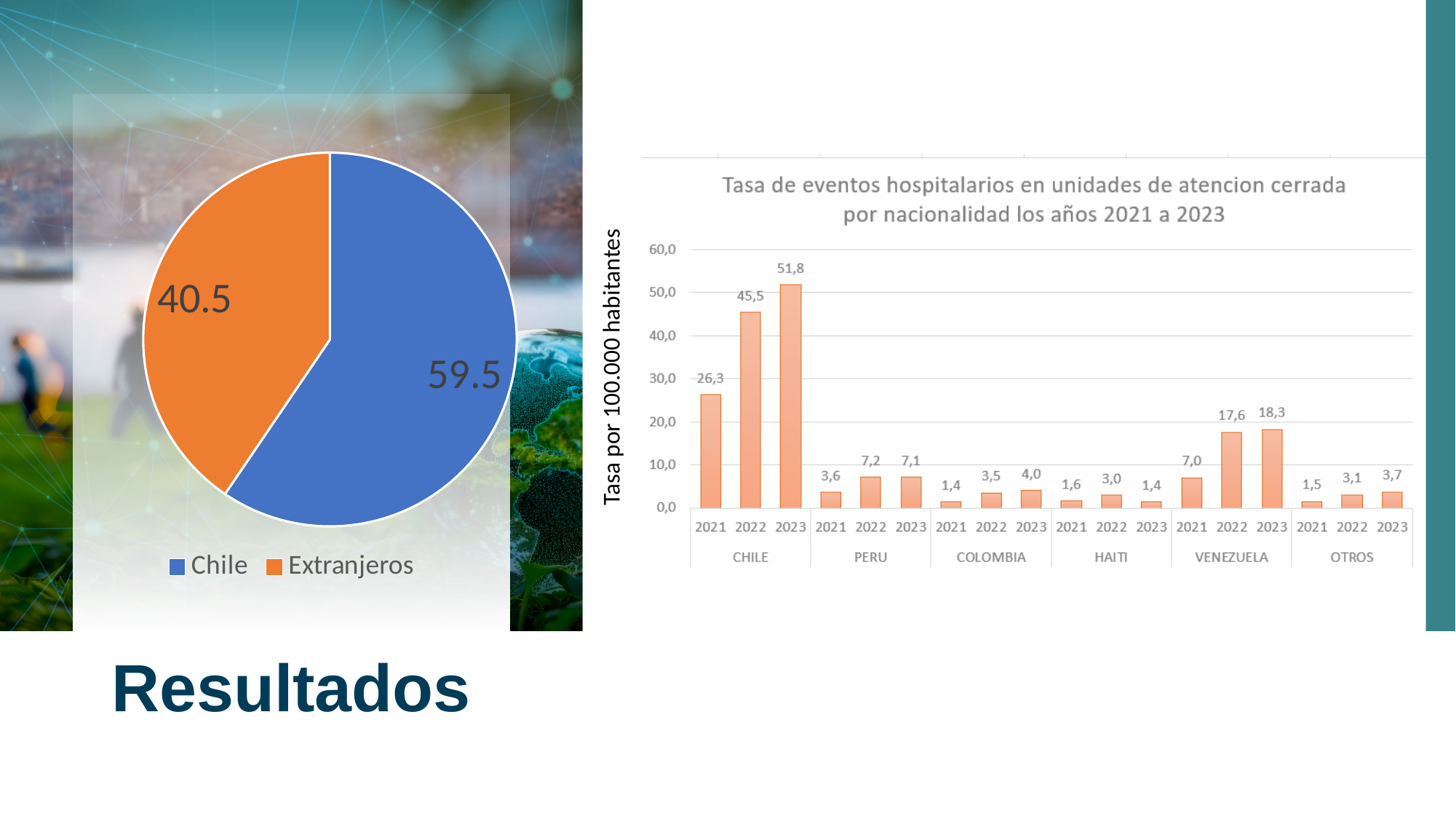
In the pie chart on the left, what is the value for Extranjeros? 40.5 In the bar chart on the right, which nationality and year has the highest value? Chile 2023 What is the y-axis label of the bar chart on the right? Tasa por 100.000 habitantes In the bar chart on the right, what is the value for Chile in 2023? 51,8 In the pie chart on the left, how many entries does the legend list? 2 In the bar chart on the right, what is the difference between the Chile values for 2023 and 2021? 25,5 In the bar chart on the right, how many nationality groups are shown on the x axis? 6 In the bar chart on the right, do the values for Colombia rise or fall from 2021 to 2023? rise In the pie chart on the left, which slice is larger, Chile or Extranjeros? Chile In the pie chart on the left, what is the value for Chile? 59.5 What kind of chart is the chart on the right, titled 'Tasa de eventos hospitalarios en unidades de atencion cerrada por nacionalidad los años 2021 a 2023'? bar chart In the bar chart on the right, what is the value for Venezuela in 2022? 17,6